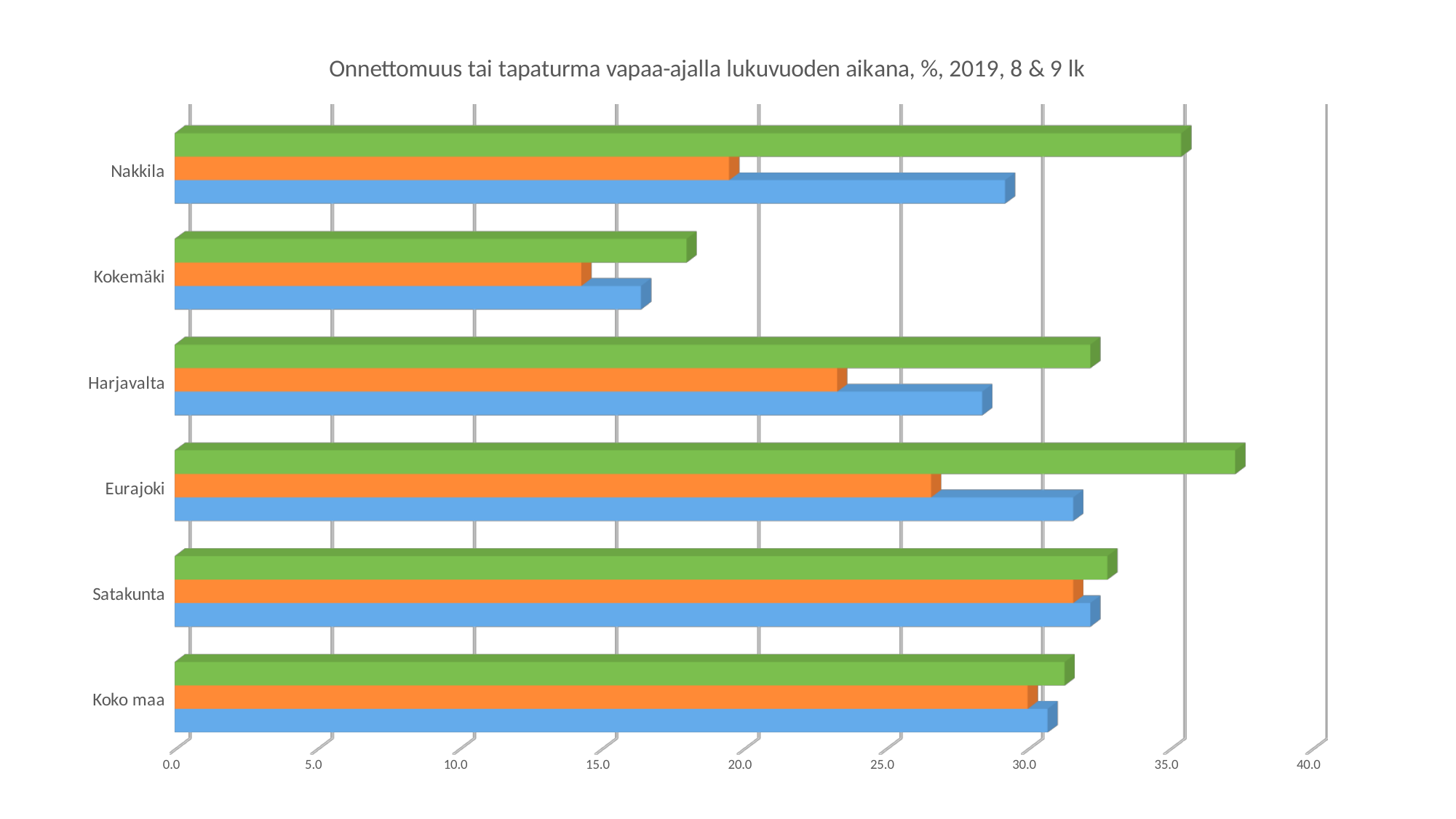
Which category has the longest green bar? Eurajoki Is the orange bar for Harjavalta greater or less than 25.0? less For Nakkila, which is longer: the green bar or the orange bar? the green bar Which category has the shortest green bar? Kokemäki What is the title of the chart? Onnettomuus tai tapaturma vapaa-ajalla lukuvuoden aikana, %, 2019, 8 & 9 lk Is the green bar for Eurajoki greater or less than 35.0? greater Which category has the longest orange bar? Satakunta How many categories are shown on the vertical axis of the chart? 6 How many bars are drawn for each category in the chart? 3 Is the green bar for Kokemäki greater or less than 20.0? less Which category has the shortest blue bar? Kokemäki What kind of chart is shown on the slide? bar chart